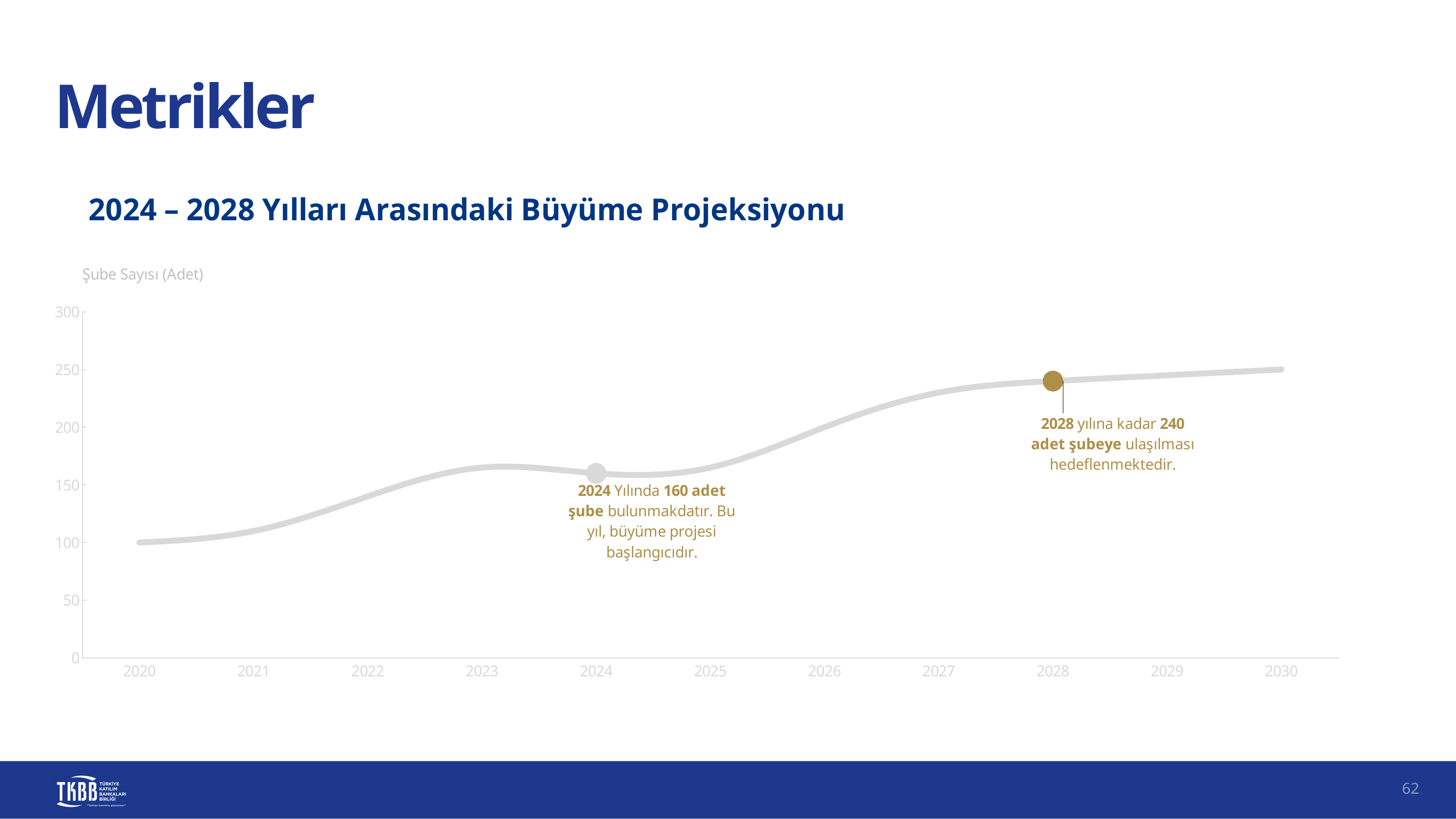
What is the label of the y axis? Şube Sayısı (Adet) What is the title of the chart? 2024 – 2028 Yılları Arasındaki Büyüme Projeksiyonu Is the value for 2026 greater or less than 150? greater How many years are labelled on the x axis? 11 What is the targeted number of branches for 2028 according to the annotation? 240 What is the difference between the 2028 target and the 2024 value? 80 Do the values generally rise or fall from 2020 to 2030? rise Which year has the larger value, 2024 or 2028? 2028 What kind of chart is shown on the slide? line chart What is the number of branches (Şube Sayısı) in 2024 according to the annotation? 160 Is the value for 2020 greater or less than 150? less Is the value for 2030 greater or less than 200? greater